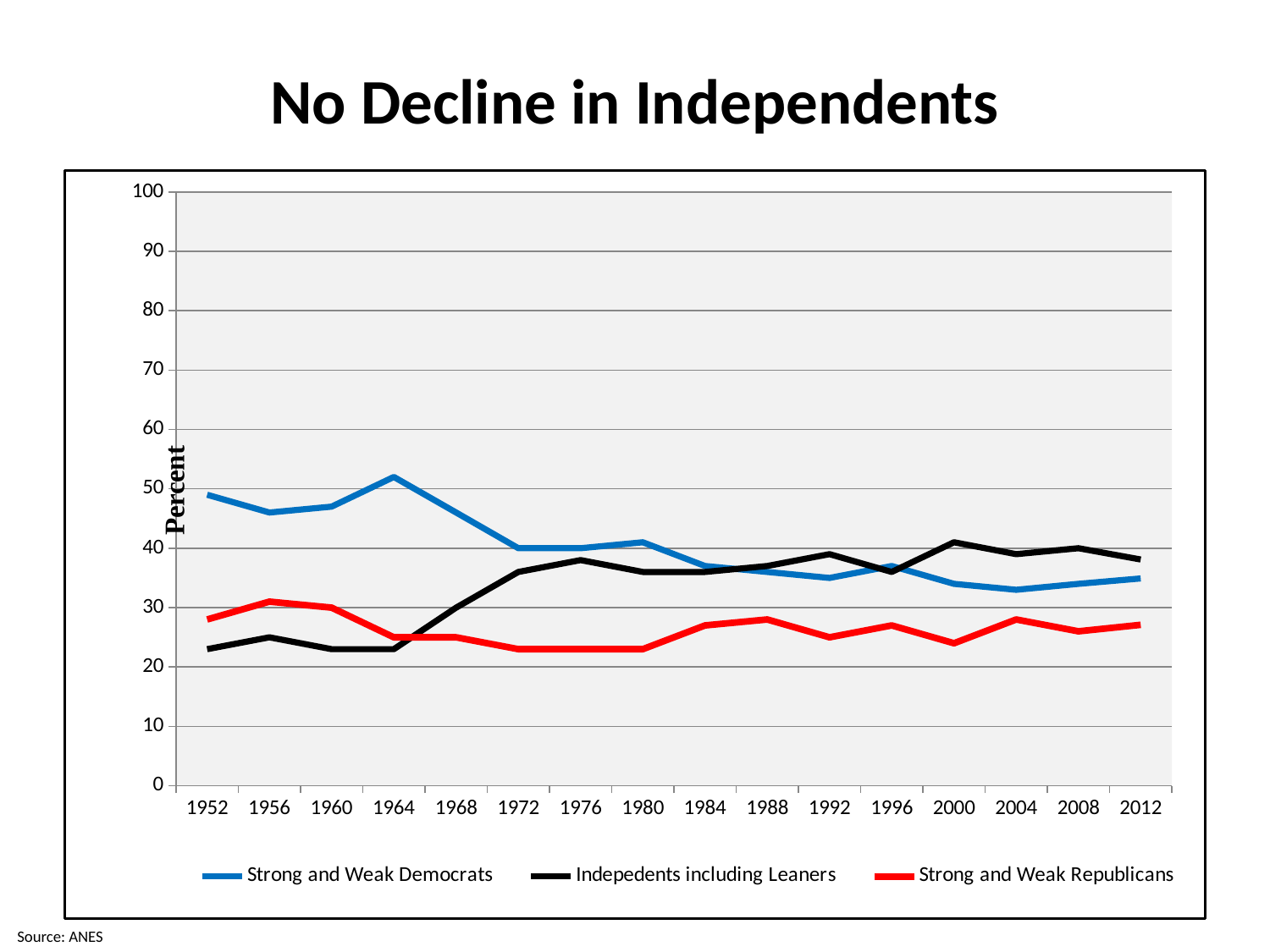
What is the title of the chart? No Decline in Independents How many years are plotted along the x axis? 16 Does the Strong and Weak Democrats line generally rise or fall from 1952 to 2012? fall Is the value for Indepedents including Leaners in 1952 greater or less than 30? less How many series does the legend list? 3 Is the value for Strong and Weak Democrats in 2004 greater or less than 40? less What kind of chart is shown on the slide? line chart In 2012, which series has the lowest value? Strong and Weak Republicans In 1952, which series has the highest value? Strong and Weak Democrats Is the value for Strong and Weak Democrats in 1964 greater or less than 50? greater What is the label on the vertical axis? Percent